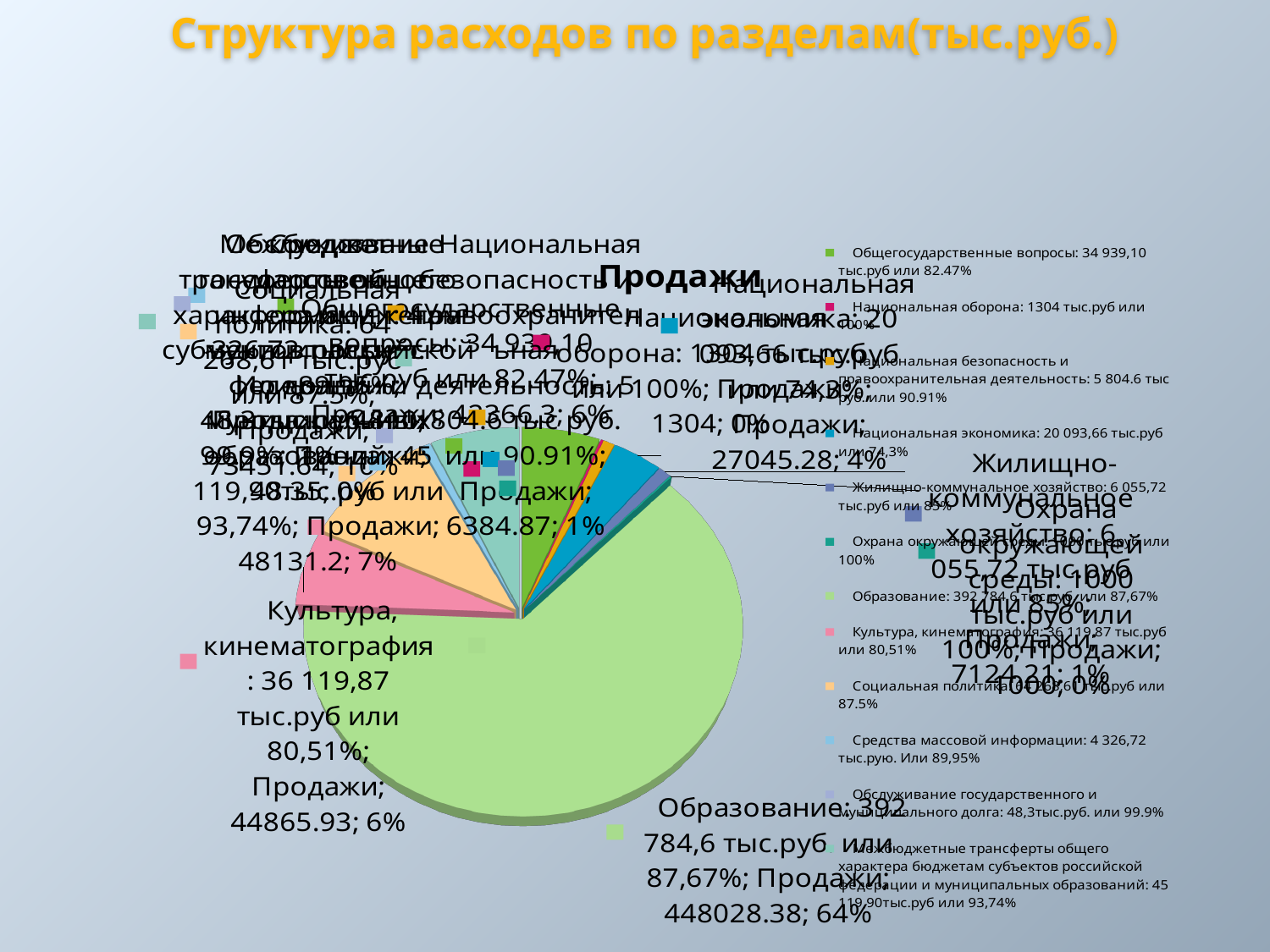
What is the plotted value for Культура, кинематография? 44865.93 What share of the pie does the Национальная экономика slice represent? 4% What is the plotted value for Образование? 448028.38 Which slice is larger, Образование or Культура, кинематография? Образование What is the title of the chart? Продажи What is the name of the data series shown in the data labels? Продажи What kind of chart is shown on the slide? pie chart What share of the pie does the Образование slice represent? 64% What share of the pie does the Культура, кинематография slice represent? 6% Which category has the largest slice of the pie? Образование How many categories does the legend list? 12 What is the plotted value for Национальная оборона? 1304